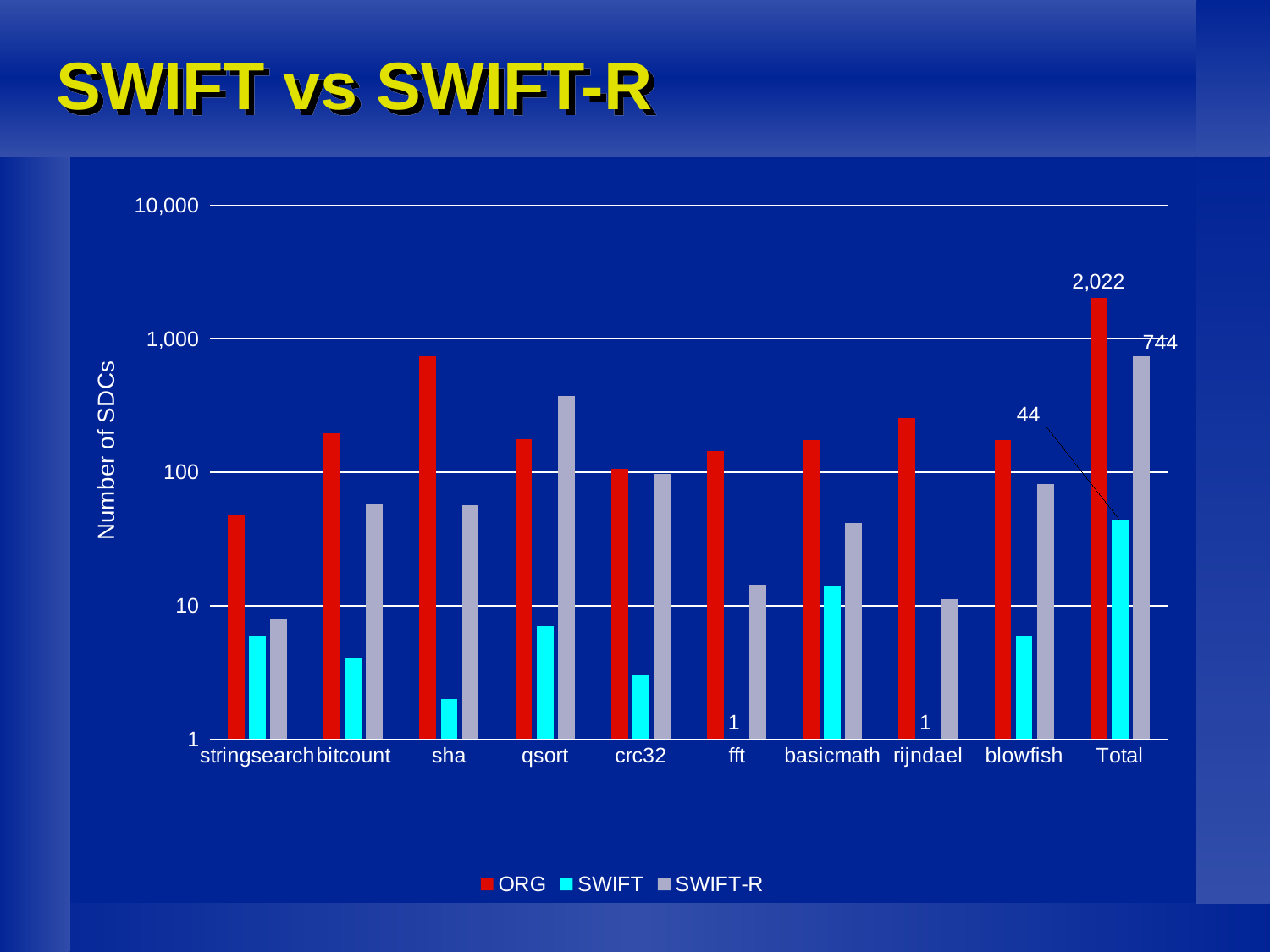
What is the SWIFT value for fft? 1 How many categories are shown on the x axis? 10 What is the SWIFT value for Total? 44 What is the SWIFT-R value for Total? 744 Is the SWIFT-R value for qsort greater or less than 100? greater How many series does the legend list? 3 What is the difference between the SWIFT-R and SWIFT values for Total? 700 What is the difference between the ORG and SWIFT-R values for Total? 1,278 What is the ORG value for Total? 2,022 Which category has the highest SWIFT-R value? Total Which category has the lowest ORG value? stringsearch Which is larger, the ORG value for sha or the ORG value for qsort? sha